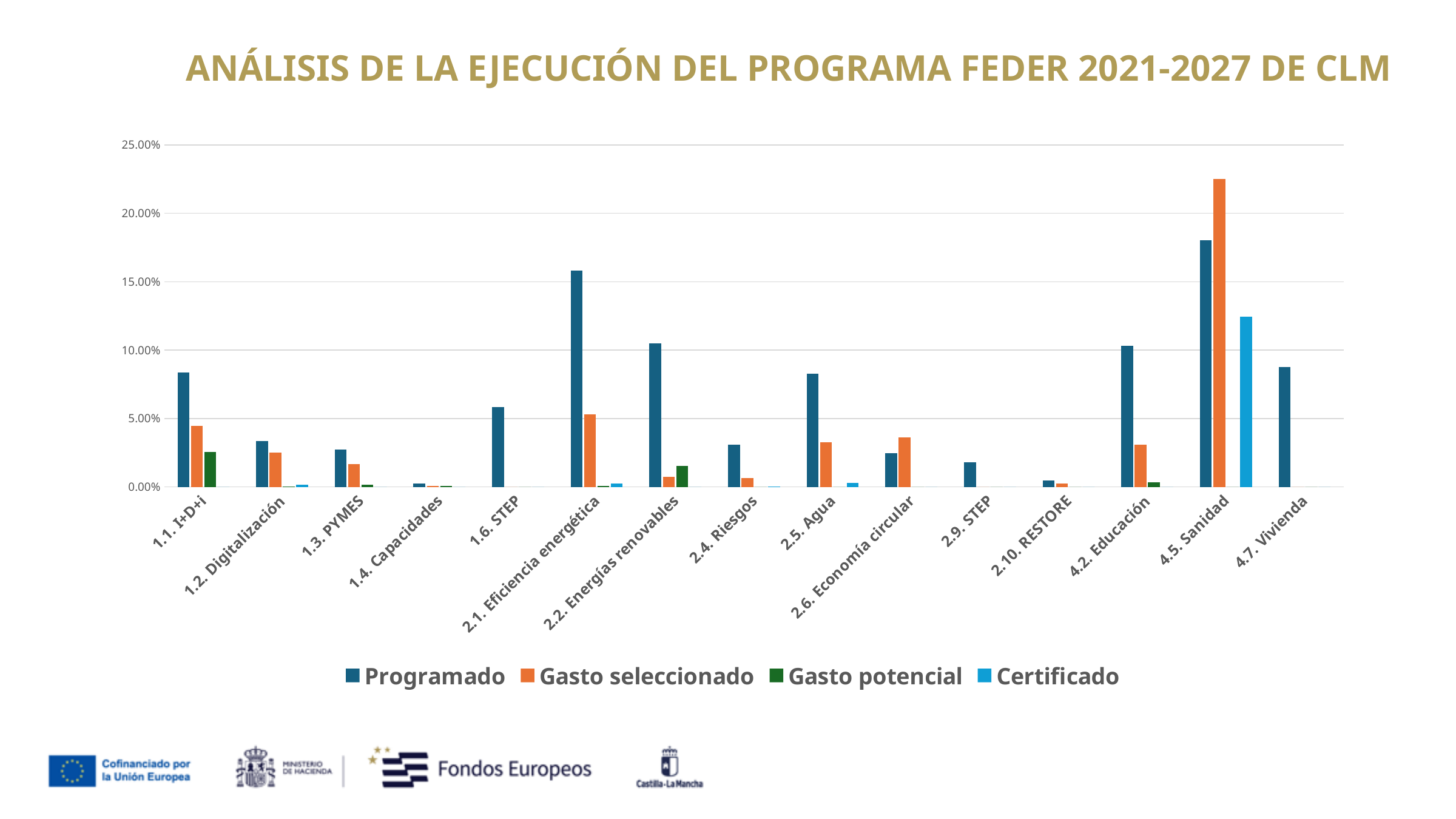
Is the Programado value for 2.1. Eficiencia energética greater or less than 15.00%? greater Is the Certificado value for 4.5. Sanidad greater or less than 10.00%? greater Which category has the highest Certificado value? 4.5. Sanidad What kind of chart is shown on the slide? Bar chart How many categories are shown on the x axis? 15 Which category has the highest Gasto seleccionado value? 4.5. Sanidad How many series does the legend list? 4 Which series is shown in orange in the legend? Gasto seleccionado Is the Programado value for 1.1. I+D+i greater or less than 10.00%? less Which category has the highest Programado value? 4.5. Sanidad For 2.6. Economía circular, which is larger: Programado or Gasto seleccionado? Gasto seleccionado